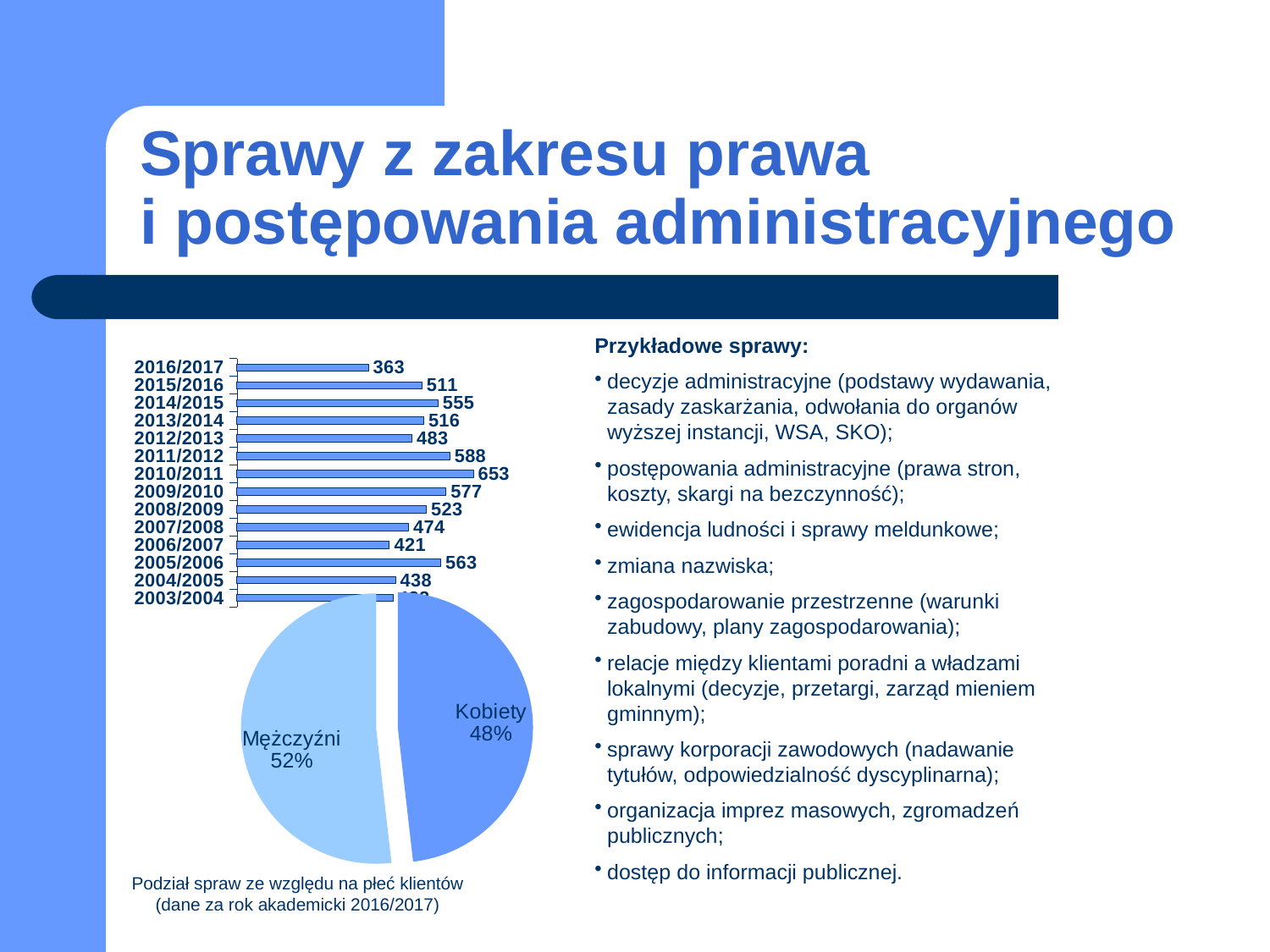
How many academic years are listed in the bar chart? 14 In the bar chart, which is larger, the value for 2014/2015 or the value for 2013/2014? 2014/2015 In the bar chart, what is the value for 2016/2017? 363 What kind of chart shows the values by academic year? bar chart In the bar chart, what is the value for 2005/2006? 563 In the pie chart, which slice is larger, Kobiety or Mężczyźni? Mężczyźni What is the caption below the pie chart? Podział spraw ze względu na płeć klientów (dane za rok akademicki 2016/2017) In the bar chart, what is the difference between the values for 2015/2016 and 2016/2017? 148 In the pie chart, what share is labelled Kobiety? 48% In the bar chart, what is the value for 2010/2011? 653 In the bar chart, which academic year has the highest value? 2010/2011 In the bar chart, what is the difference between the values for 2011/2012 and 2012/2013? 105